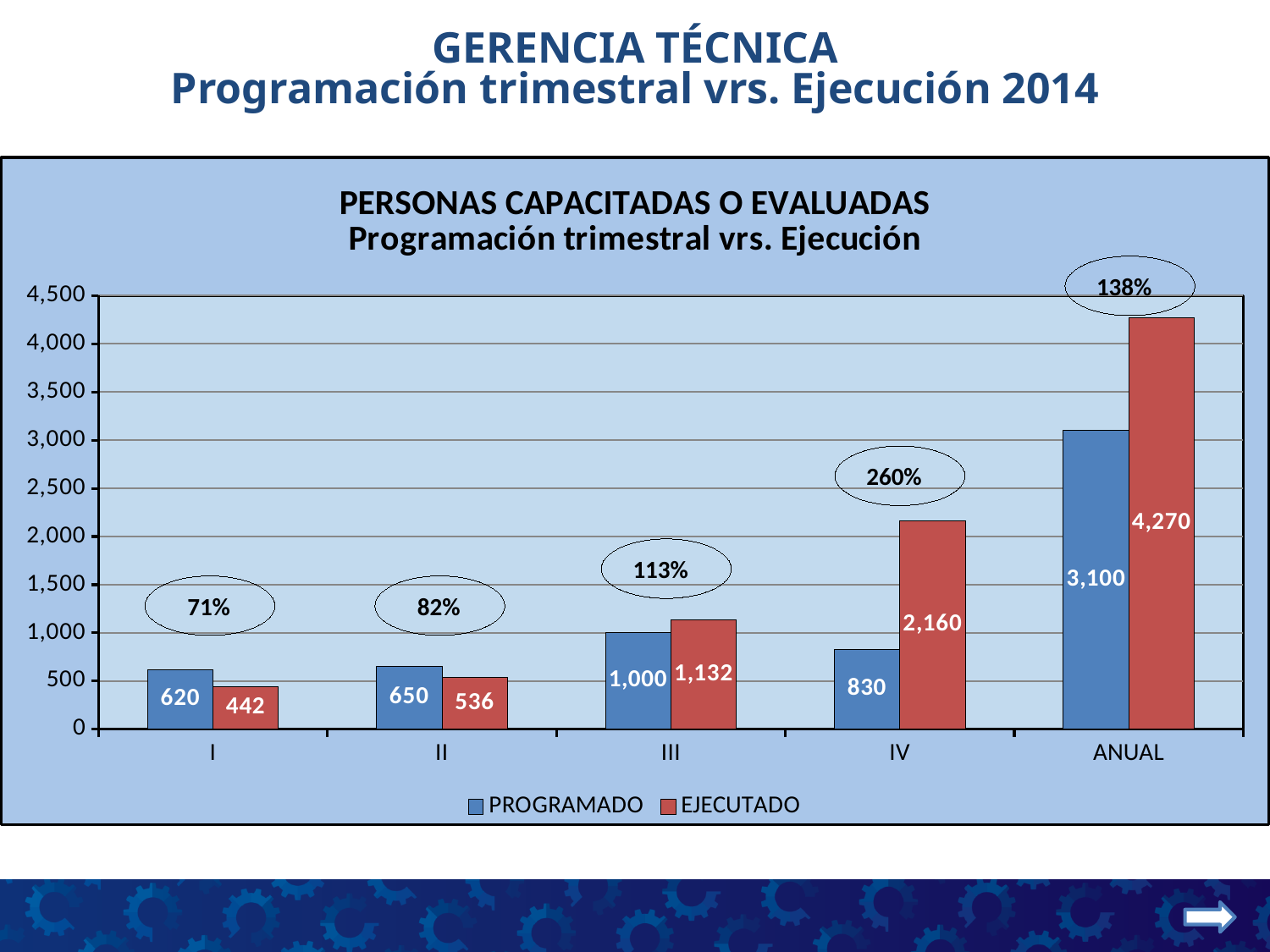
What percentage is shown in the oval above quarter IV? 260% What is the difference between the EJECUTADO and PROGRAMADO values for quarter IV? 1,330 For quarter II, which is larger, PROGRAMADO or EJECUTADO? PROGRAMADO Which category has the highest EJECUTADO value? ANUAL What is the PROGRAMADO value for quarter III? 1,000 What is the EJECUTADO value for quarter IV? 2,160 What kind of chart is shown? bar chart How many series does the legend list? 2 Is the PROGRAMADO value for ANUAL greater or less than 3,000? greater What is the EJECUTADO value for ANUAL? 4,270 How many categories are shown on the x axis? 5 Which category has the lowest EJECUTADO value? I